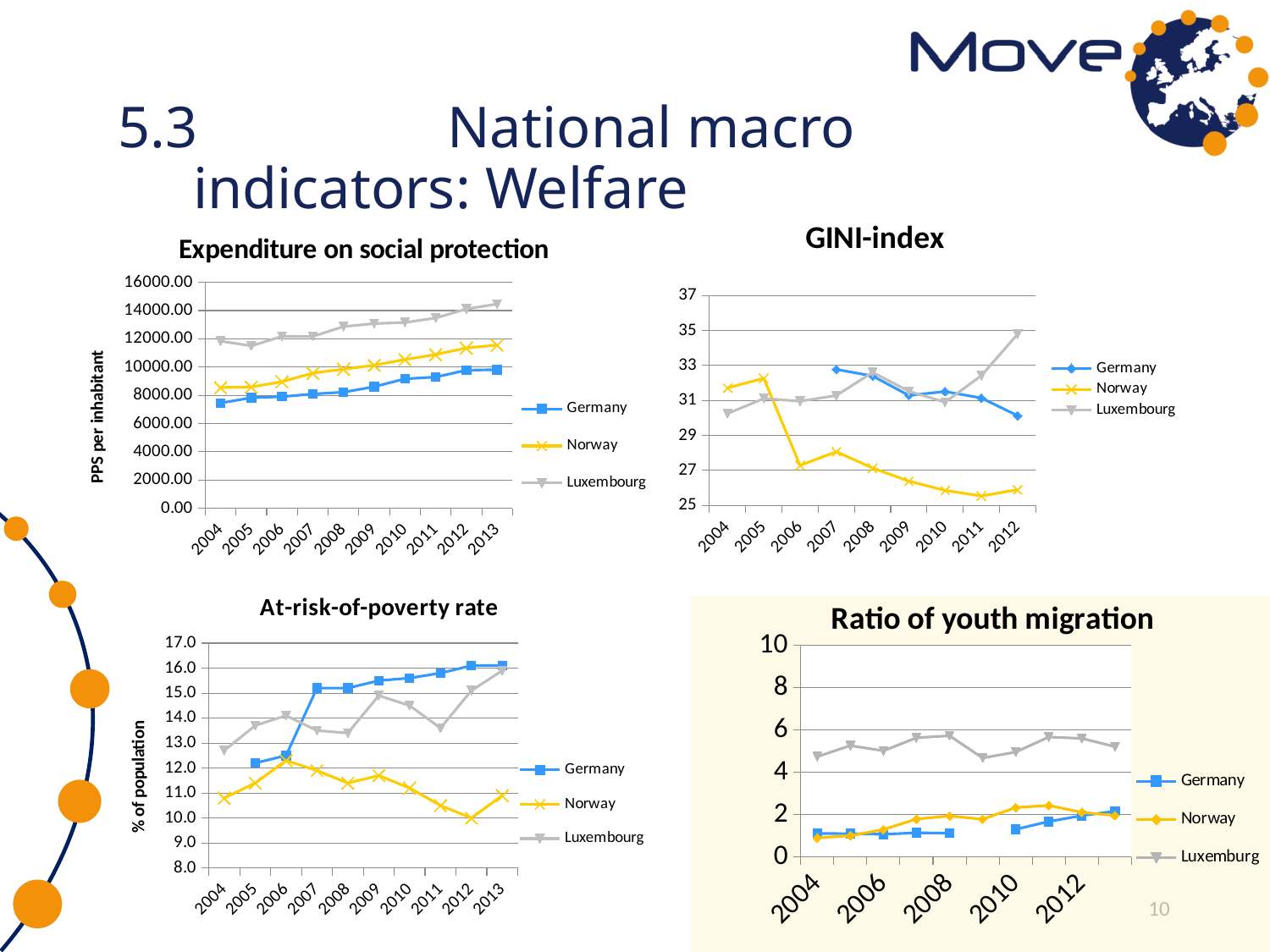
In the 'GINI-index' chart, how many years are shown on the x axis? 9 In the 'Expenditure on social protection' chart, is the value for Luxembourg in 2013 greater or less than 14000.00? greater In the 'At-risk-of-poverty rate' chart, is the value for Germany in 2013 greater or less than 15.0? greater In the 'Ratio of youth migration' chart, which series has the highest values across the whole period? Luxemburg In the 'GINI-index' chart, which country has the lowest value in 2012? Norway In the 'GINI-index' chart, does the Norway series rise or fall from 2005 to 2011? fall In the 'At-risk-of-poverty rate' chart, which is larger in 2013, Germany or Norway? Germany In the 'GINI-index' chart, is the value for Luxembourg in 2012 greater or less than 33? greater In the 'Expenditure on social protection' chart, does the Norway series rise or fall from 2004 to 2013? rise In the 'Expenditure on social protection' chart, which country has the highest expenditure in 2013? Luxembourg What kind of chart is the 'Expenditure on social protection' chart? line chart In the 'Expenditure on social protection' chart, how many series does the legend list? 3